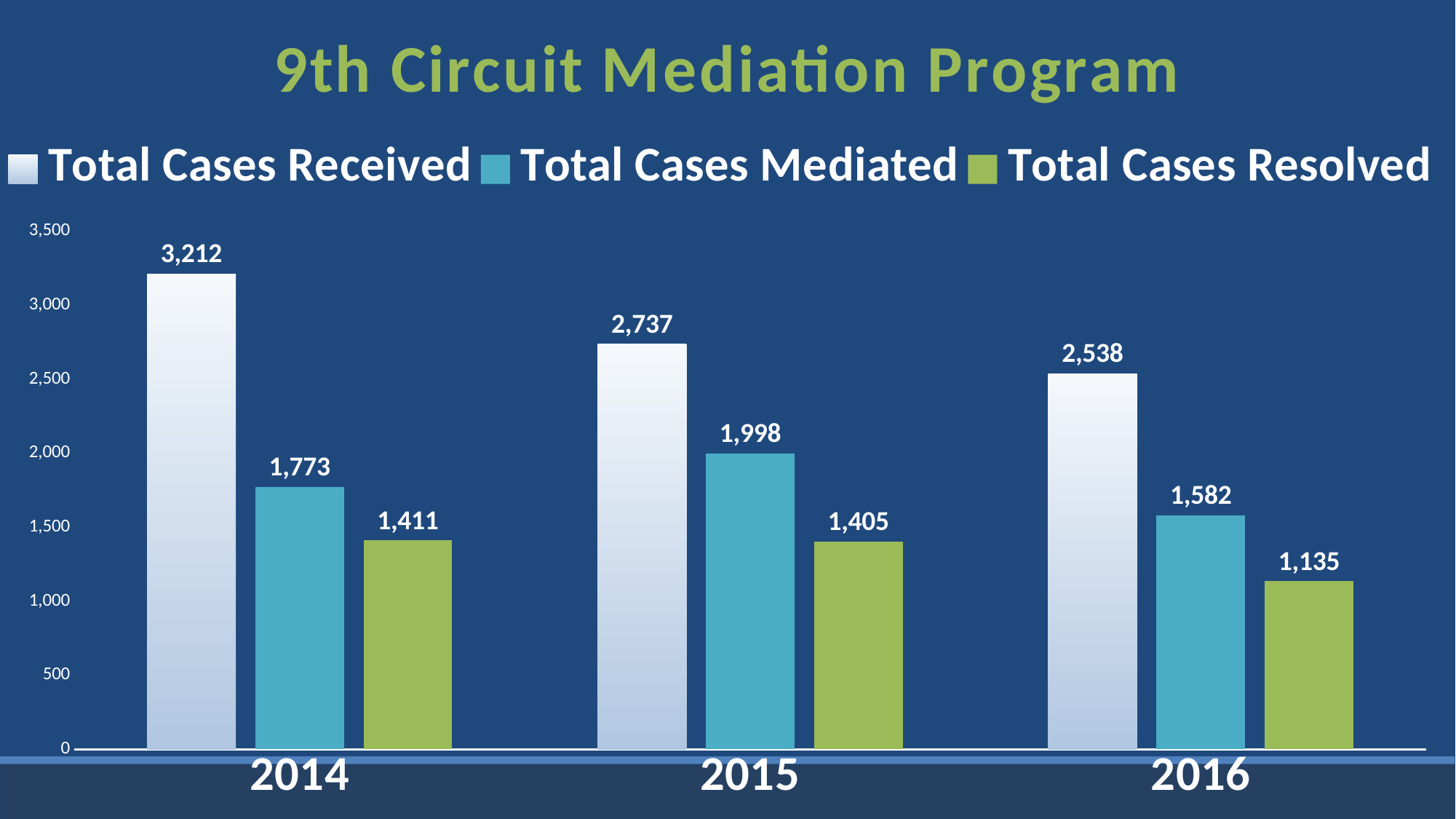
Which year has the highest value for Total Cases Received? 2014 Which year has the lowest value for Total Cases Resolved? 2016 Does the value for Total Cases Received rise or fall from 2014 to 2016? Fall What kind of chart is shown on the slide? Bar chart Which is larger: Total Cases Mediated in 2014 or Total Cases Mediated in 2015? Total Cases Mediated in 2015 What is the value for Total Cases Mediated in 2015? 1,998 What is the difference between Total Cases Received and Total Cases Mediated in 2016? 956 How many years are shown on the x axis? 3 How many series does the legend list? 3 What is the value for Total Cases Received in 2014? 3,212 What is the title of the chart? 9th Circuit Mediation Program What is the value for Total Cases Resolved in 2016? 1,135